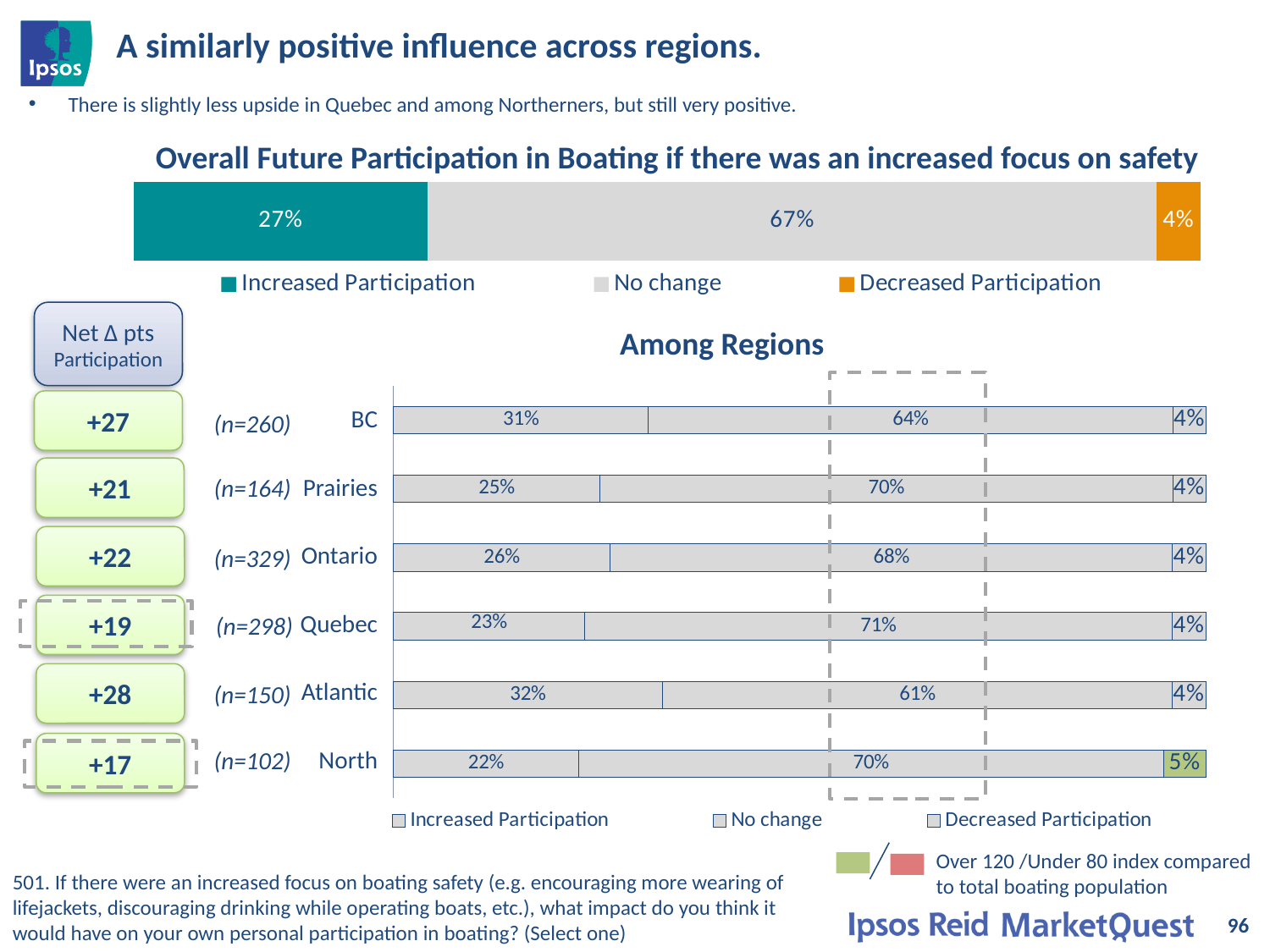
What type of chart is the 'Among Regions' chart? Stacked bar chart How many regions are shown in the 'Among Regions' chart? 6 In the 'Among Regions' chart, what is the No change value for Quebec? 71% In the 'Among Regions' chart, which region has the lowest Increased Participation value? North In the top overall chart, what is the value for No change? 67% In the 'Among Regions' chart, what is the difference between the Increased Participation values for Atlantic and Quebec? 9 percentage points In the 'Among Regions' chart, what is the Increased Participation value for BC? 31% In the top overall chart, what is the value for Increased Participation? 27% In the 'Among Regions' chart, which is larger: the No change value for Prairies or for Ontario? Prairies In the 'Among Regions' chart, which region has the highest Increased Participation value? Atlantic How many series does the legend of the 'Among Regions' chart list? 3 In the 'Among Regions' chart, what is the Decreased Participation value for North? 5%